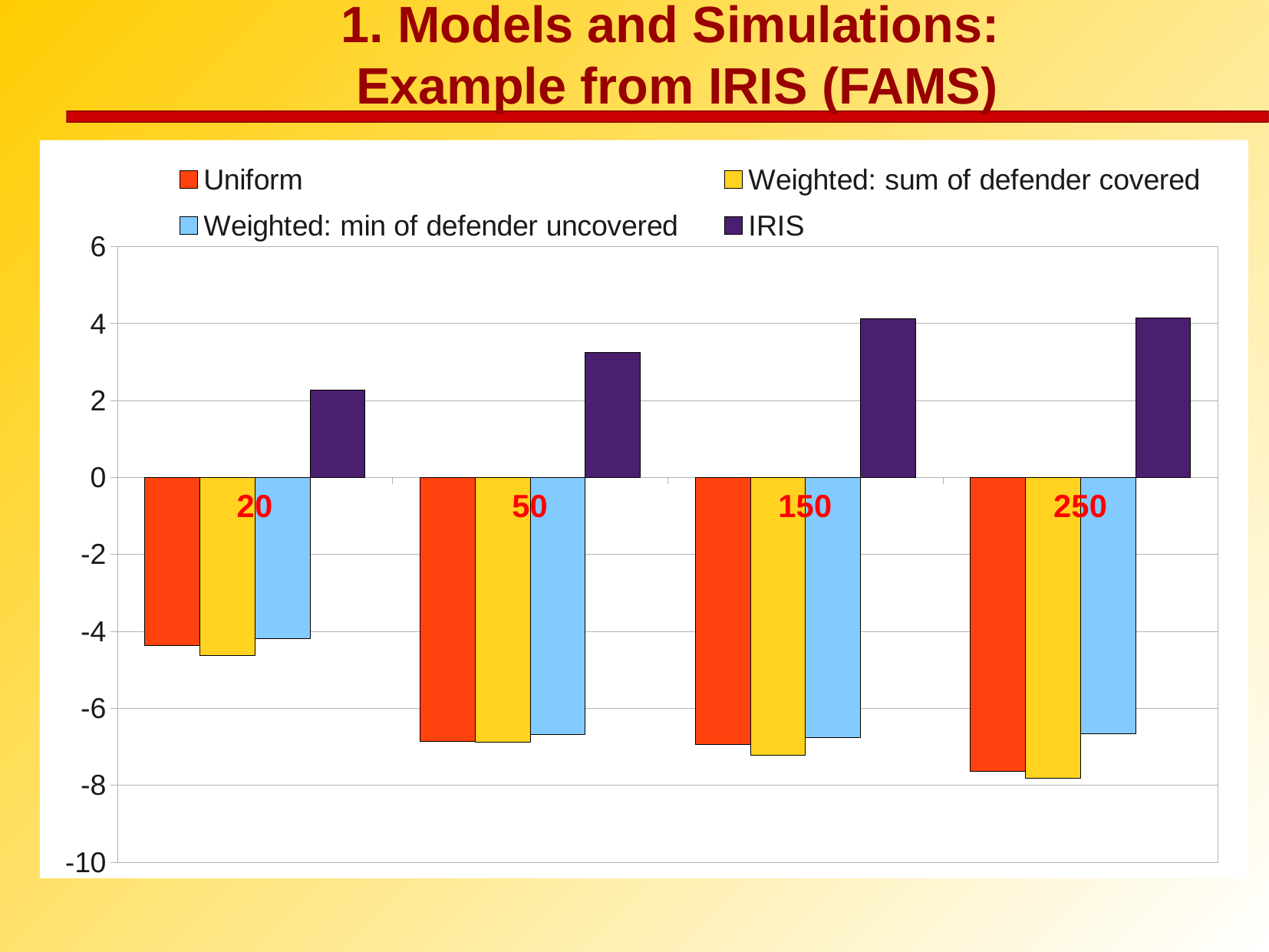
Which is larger, the Uniform value for category 20 or the Uniform value for category 250? category 20 How many categories are shown along the x axis of the chart? 4 Which series is shown in light blue in the legend? Weighted: min of defender uncovered What kind of chart is shown on the slide? bar chart For which category is the IRIS value lowest? 20 Do the IRIS values rise or fall as the categories go from 20 to 250? rise Is the Uniform value for category 250 greater or less than -6? less Which is larger, the IRIS value for category 20 or the IRIS value for category 50? category 50 Which series is shown in dark purple in the legend? IRIS How many series does the chart's legend list? 4 Is the Uniform value for category 20 greater or less than -4? less Is the IRIS value for category 20 greater or less than 2? greater